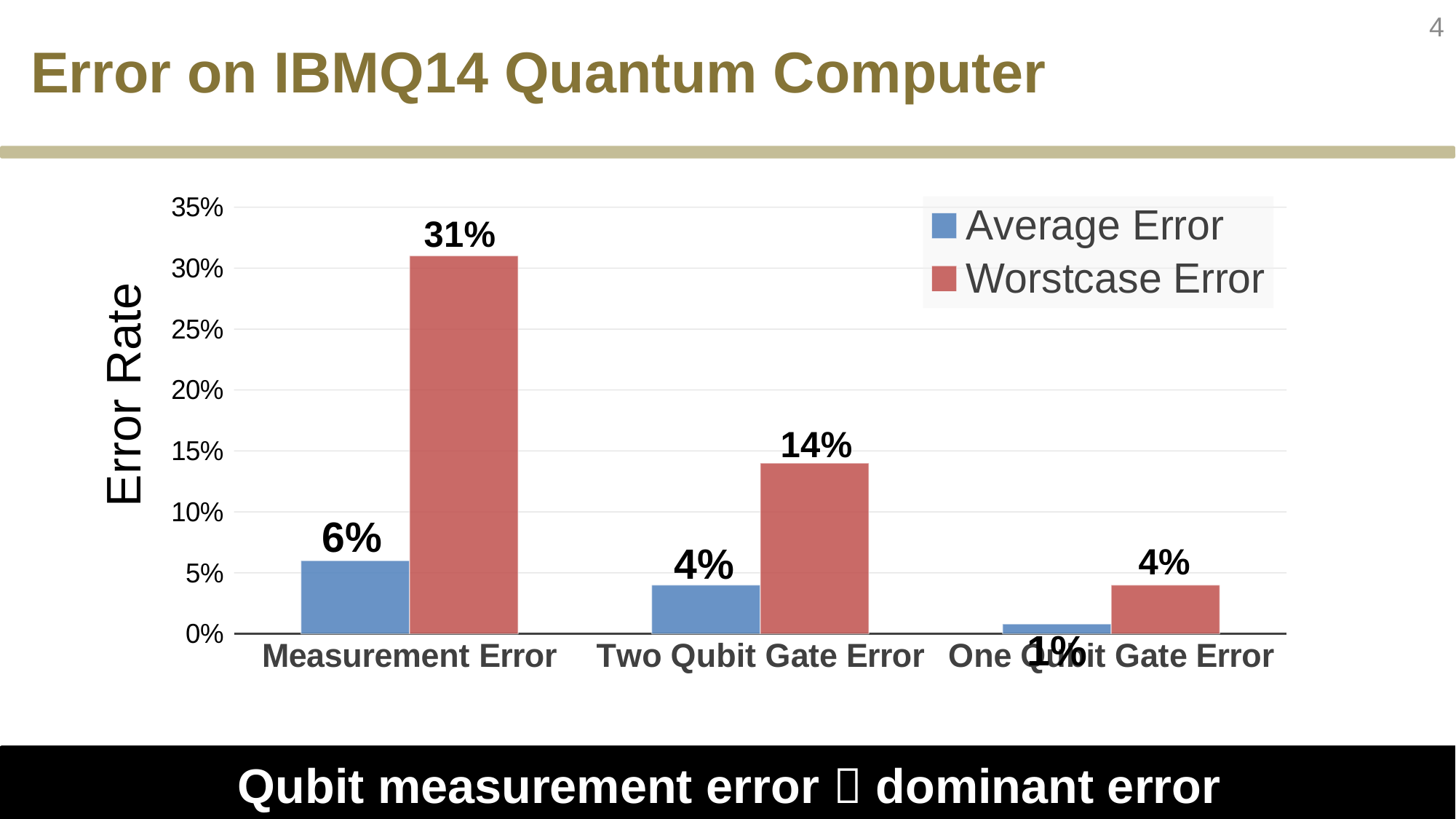
What is the Average Error for Measurement Error? 6% How many categories are shown on the x axis? 3 Which is larger: the Worstcase Error for Two Qubit Gate Error or the Worstcase Error for One Qubit Gate Error? Two Qubit Gate Error How many series does the legend list? 2 What is the Worstcase Error for One Qubit Gate Error? 4% What is the difference between the Worstcase Error and the Average Error for Measurement Error? 25% Which category has the highest Worstcase Error? Measurement Error What is the Average Error for Two Qubit Gate Error? 4% Which category has the lowest Average Error? One Qubit Gate Error What is the Worstcase Error for Measurement Error? 31% What kind of chart is shown on the slide? Bar chart What is the label of the y axis? Error Rate